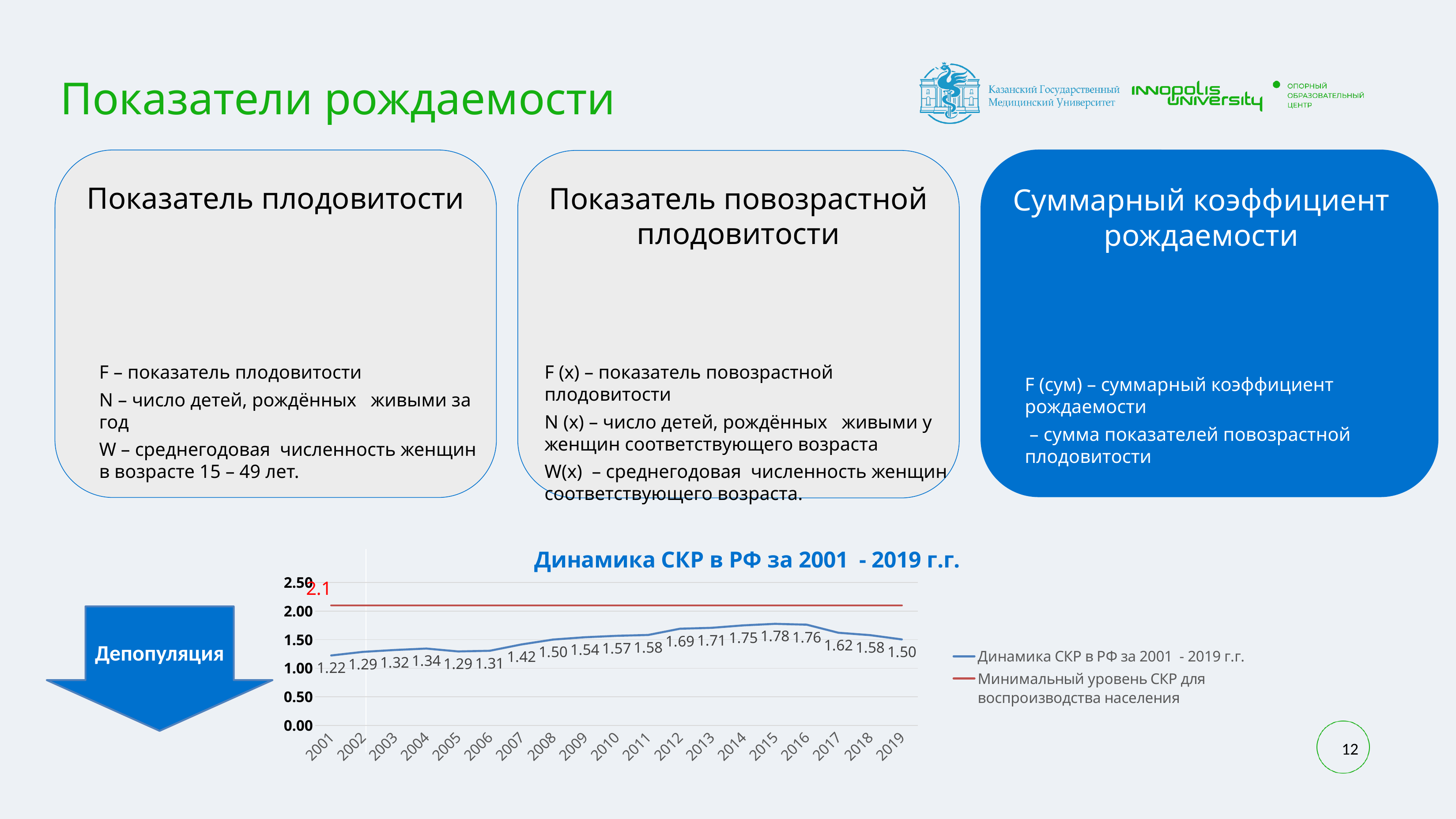
What is the value of the red line marking the minimum СКР level for population reproduction? 2.1 In which year is the СКР value lowest? 2001 Is the СКР value for 2015 greater or less than 2.00? less How many series does the legend list? 2 What is the value of the СКР series for 2001? 1.22 What type of chart is shown on the slide? line chart Which year has a higher СКР value, 2012 or 2017? 2012 What is the value of the СКР series for 2015? 1.78 What is the value of the СКР series for 2019? 1.50 What is the difference between the СКР values for 2015 and 2001? 0.56 How many years are plotted on the x axis? 19 In which year is the СКР value highest? 2015